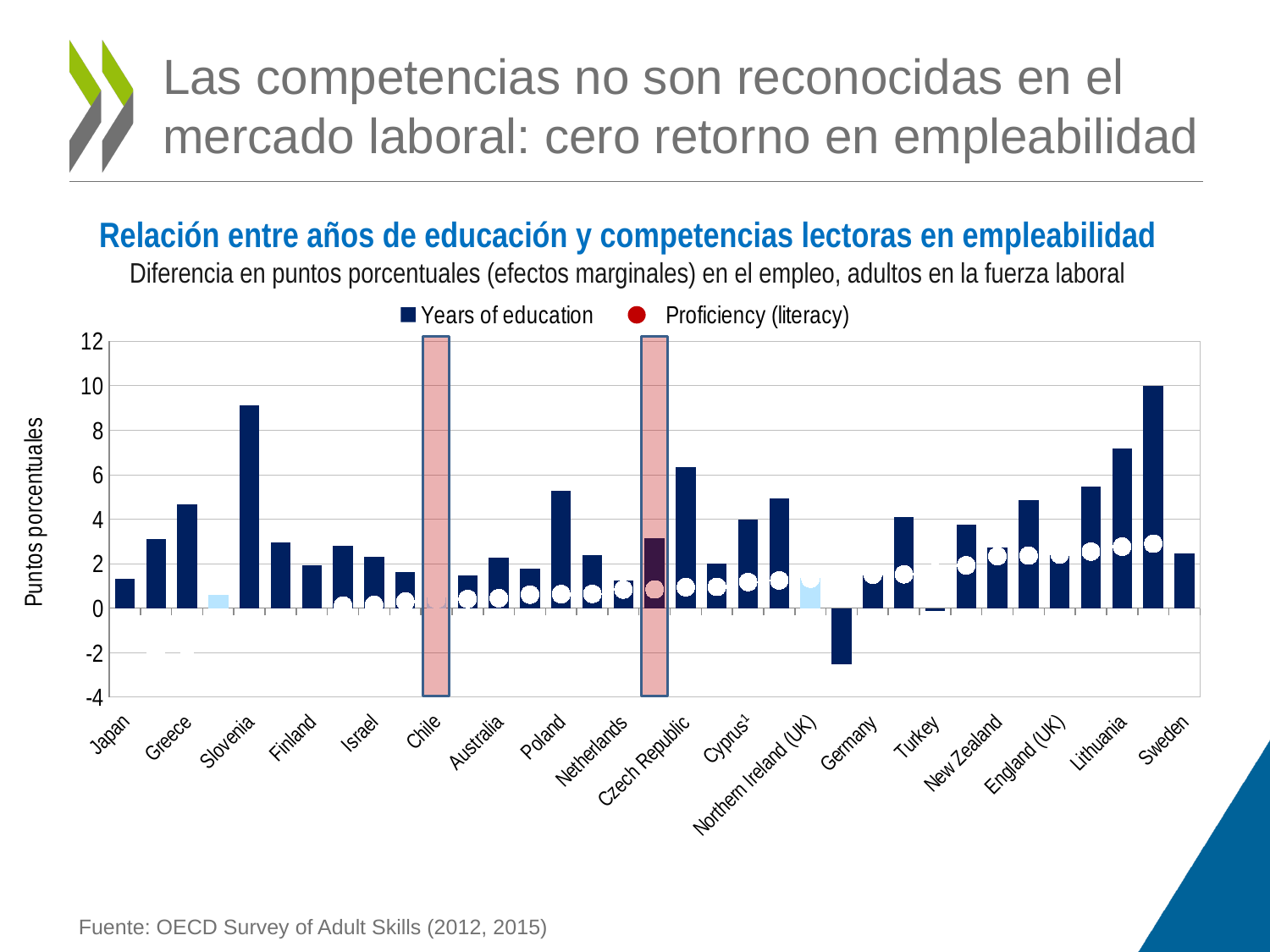
Is the Years of education value for Lithuania greater or less than 6? greater Is the Years of education value for Poland greater or less than 4? greater What is the label on the vertical axis? Puntos porcentuales What are the two series named in the legend? Years of education; Proficiency (literacy) Is the Years of education value for Chile greater or less than 2? less Which has the larger Years of education value, Poland or Finland? Poland What is the highest value shown on the vertical axis? 12 How many series does the legend list? 2 What kind of chart is shown on the slide? Combination chart: bars (Years of education) with dot markers (Proficiency) Which has the larger Years of education value, Slovenia or Japan? Slovenia